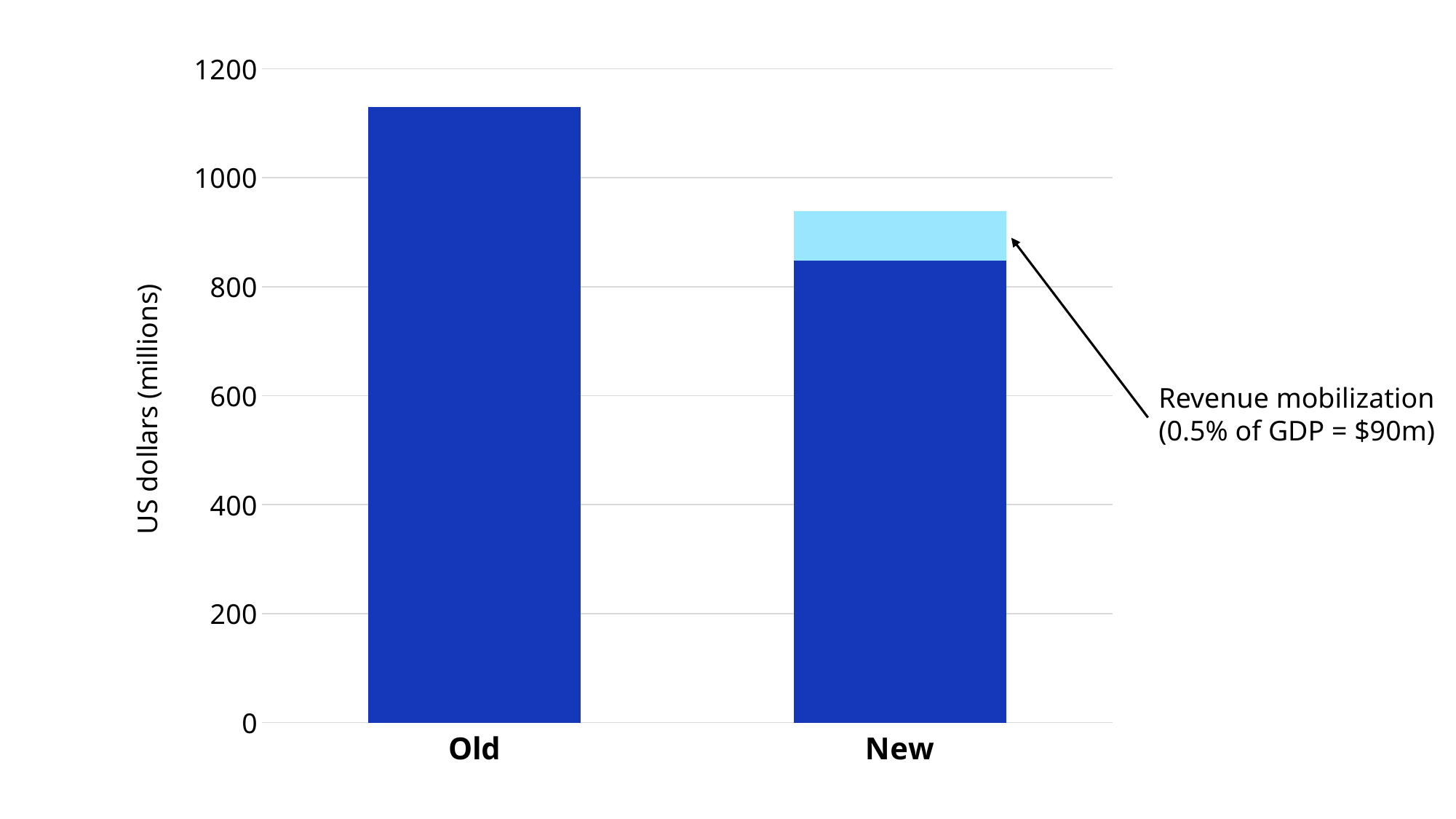
Is the value for Old greater or less than 1000? greater Which category has the taller bar, Old or New? Old How many categories are shown on the x axis? 2 Which category has the shorter bar overall? New According to the annotation, how much is the revenue mobilization segment worth? $90m Is the total for Old larger or smaller than the total for New? larger What kind of chart is shown on the slide? bar chart Is the dark blue portion of the New bar greater or less than 800? greater Is the value for Old greater or less than 1200? less What is the label on the y axis? US dollars (millions) Do the bar totals rise or fall from Old to New? fall